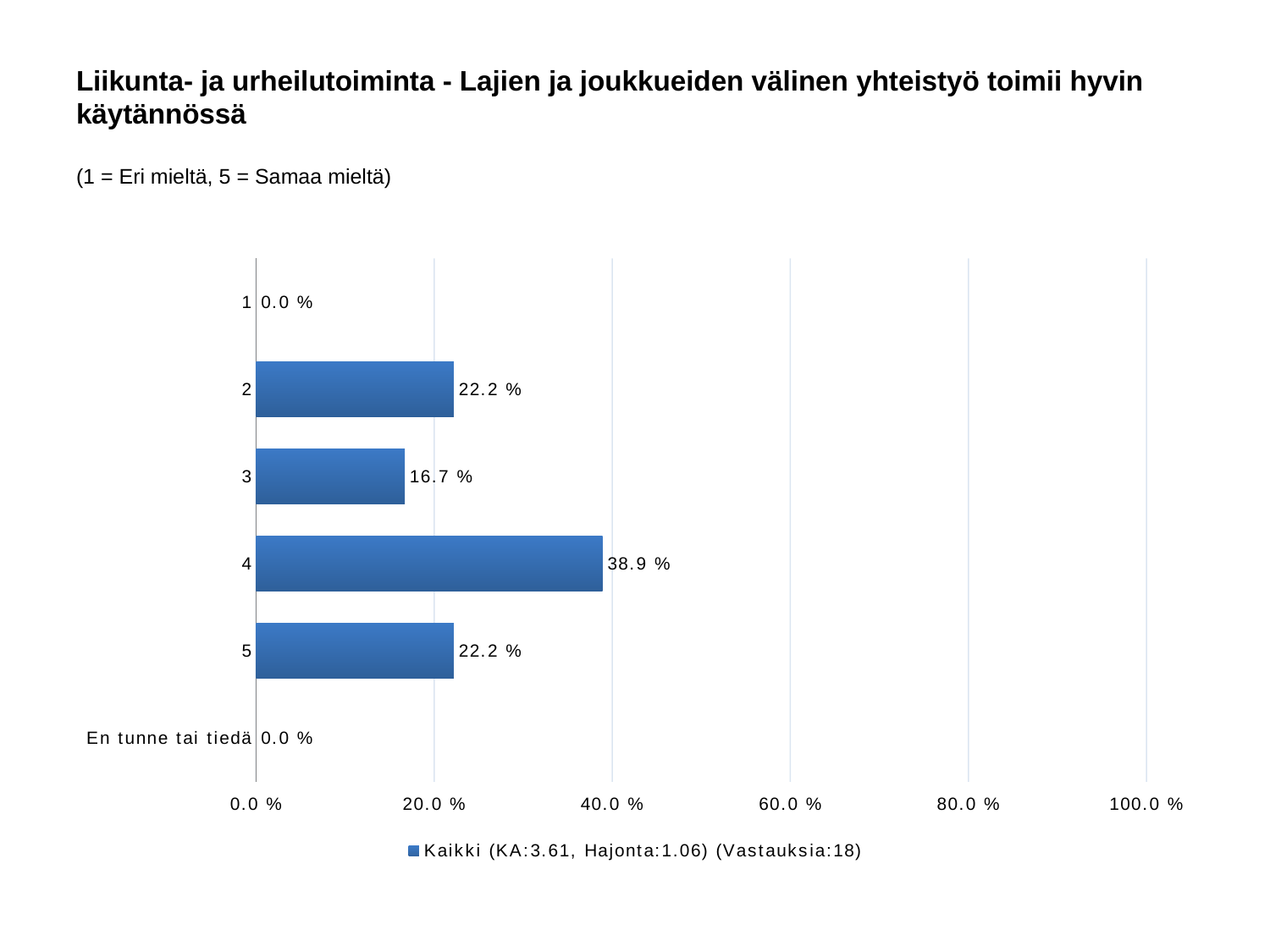
Which is larger, the value for category 3 or the value for category 5? 5 What kind of chart is shown on the slide? bar chart What is the difference between the values for category 4 and category 3? 22.2 % What is the value for 'En tunne tai tiedä'? 0.0 % How many categories are shown on the chart? 6 What is the value for category 4? 38.9 % Is the value for category 4 greater or less than 40.0 %? less How many responses (Vastauksia) does the legend report? 18 What is the value for category 2? 22.2 % What is the value for category 3? 16.7 % How many series does the legend list? 1 Which category has the highest value? 4